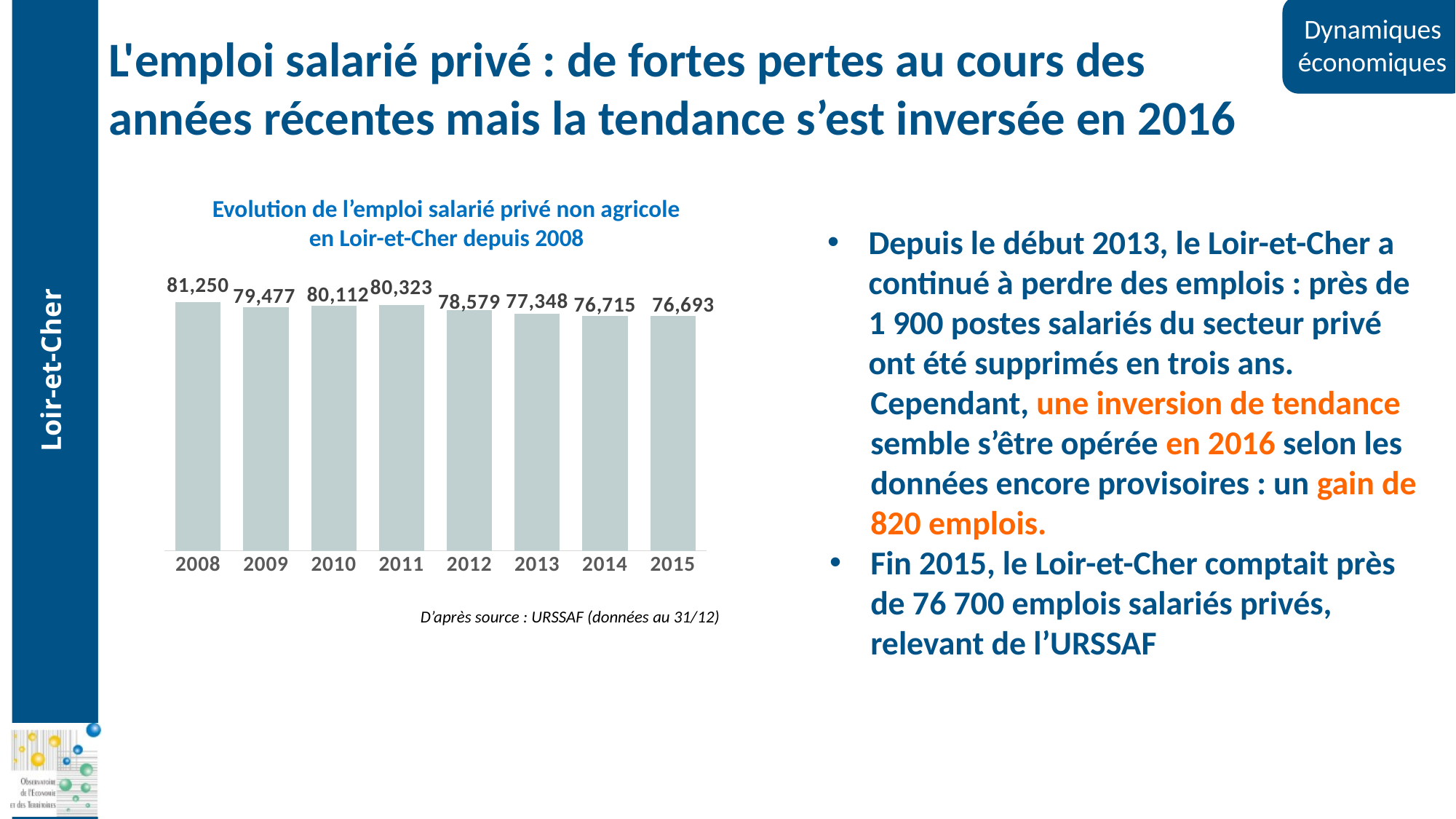
Do the values generally rise or fall from 2011 to 2015? Fall How many years are shown on the chart? 8 What kind of chart is shown? Bar chart What is the value for 2015? 76,693 What is the value for 2012? 78,579 Which year has the highest value? 2008 What is the difference between the values for 2011 and 2012? 1,744 What is the difference between the values for 2008 and 2015? 4,557 What is the title of the chart? Evolution de l’emploi salarié privé non agricole en Loir-et-Cher depuis 2008 What is the value for 2008? 81,250 Which is larger, the value for 2010 or the value for 2011? 2011 Which year has the lowest value? 2015